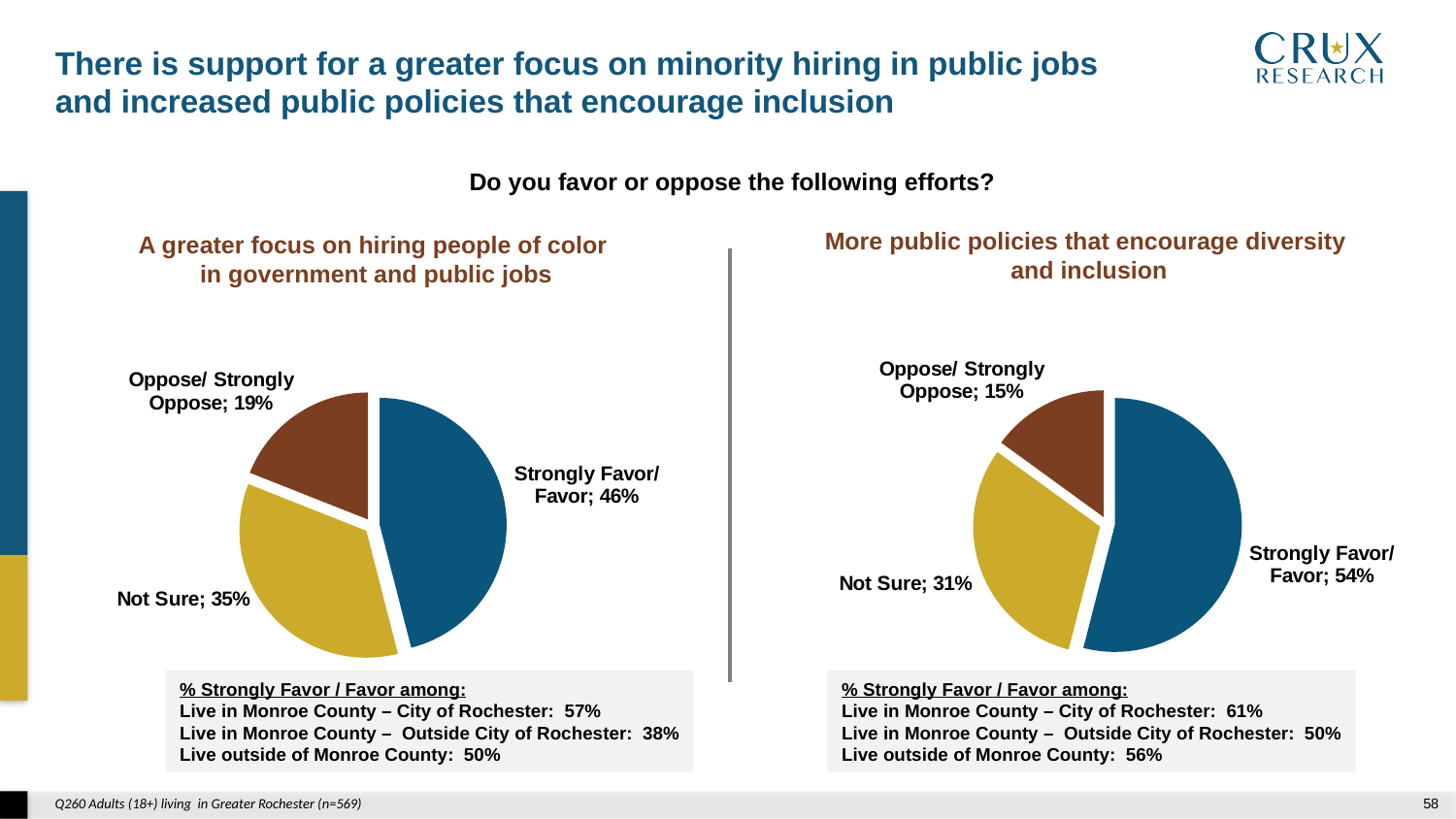
Which chart has the larger Not Sure share, the left chart on hiring people of color or the right chart on public policies for diversity and inclusion? The left chart on hiring people of color In the 'A greater focus on hiring people of color in government and public jobs' chart, what is the difference between the Strongly Favor/Favor share and the Oppose/Strongly Oppose share? 27% In the 'More public policies that encourage diversity and inclusion' chart, which slice is the smallest? Oppose/Strongly Oppose In the 'More public policies that encourage diversity and inclusion' chart, what share is Oppose/Strongly Oppose? 15% How many slices does the 'More public policies that encourage diversity and inclusion' chart have? 3 In the 'More public policies that encourage diversity and inclusion' chart, what share is Strongly Favor/Favor? 54% What question is asked above the two charts on the slide? Do you favor or oppose the following efforts? What type of chart is used on the left for 'A greater focus on hiring people of color in government and public jobs'? Pie chart In the 'A greater focus on hiring people of color in government and public jobs' chart, what share is Not Sure? 35% In the 'A greater focus on hiring people of color in government and public jobs' chart, what share is Strongly Favor/Favor? 46% In the 'More public policies that encourage diversity and inclusion' chart, what is the difference between the Strongly Favor/Favor share and the Not Sure share? 23% In the 'A greater focus on hiring people of color in government and public jobs' chart, which slice is the largest? Strongly Favor/Favor